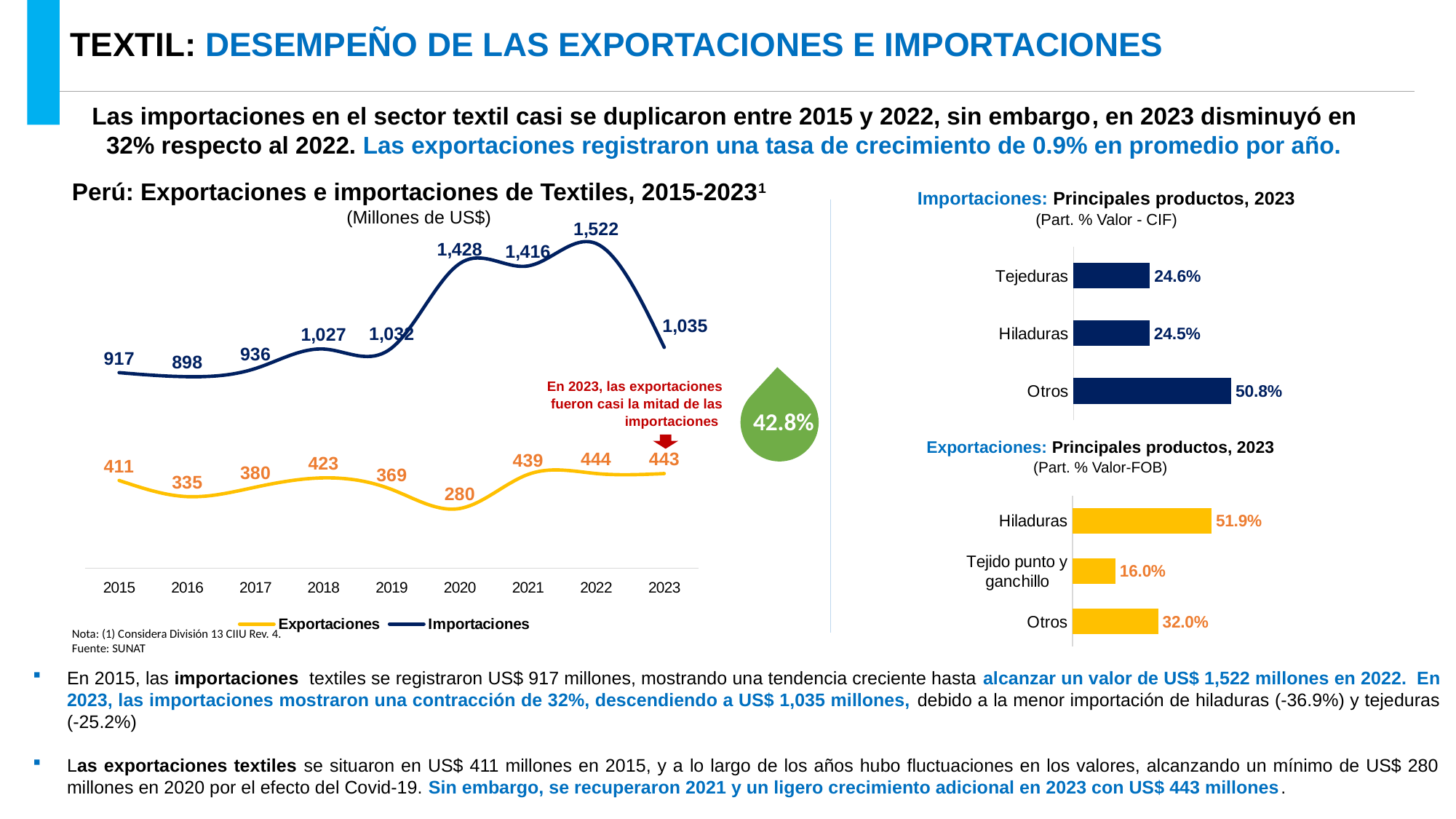
What kind of chart is 'Perú: Exportaciones e importaciones de Textiles, 2015-2023'? Line chart In the chart 'Exportaciones: Principales productos, 2023', which is larger, Hiladuras or Otros? Hiladuras In the chart 'Importaciones: Principales productos, 2023', which category has the largest share? Otros In the chart 'Perú: Exportaciones e importaciones de Textiles, 2015-2023', what was the value of Importaciones in 2022? 1,522 In the chart 'Perú: Exportaciones e importaciones de Textiles, 2015-2023', what is the difference between Importaciones and Exportaciones in 2023? 592 In the chart 'Perú: Exportaciones e importaciones de Textiles, 2015-2023', how many series does the legend list? 2 In the chart 'Perú: Exportaciones e importaciones de Textiles, 2015-2023', in which year were Importaciones highest? 2022 In the chart 'Importaciones: Principales productos, 2023', what is the share for Tejeduras? 24.6% In the chart 'Perú: Exportaciones e importaciones de Textiles, 2015-2023', how many years are shown on the x axis? 9 In the chart 'Perú: Exportaciones e importaciones de Textiles, 2015-2023', what was the value of Exportaciones in 2020? 280 In the chart 'Exportaciones: Principales productos, 2023', what is the share for Tejido punto y ganchillo? 16.0% In the chart 'Perú: Exportaciones e importaciones de Textiles, 2015-2023', in which year were Exportaciones lowest? 2020